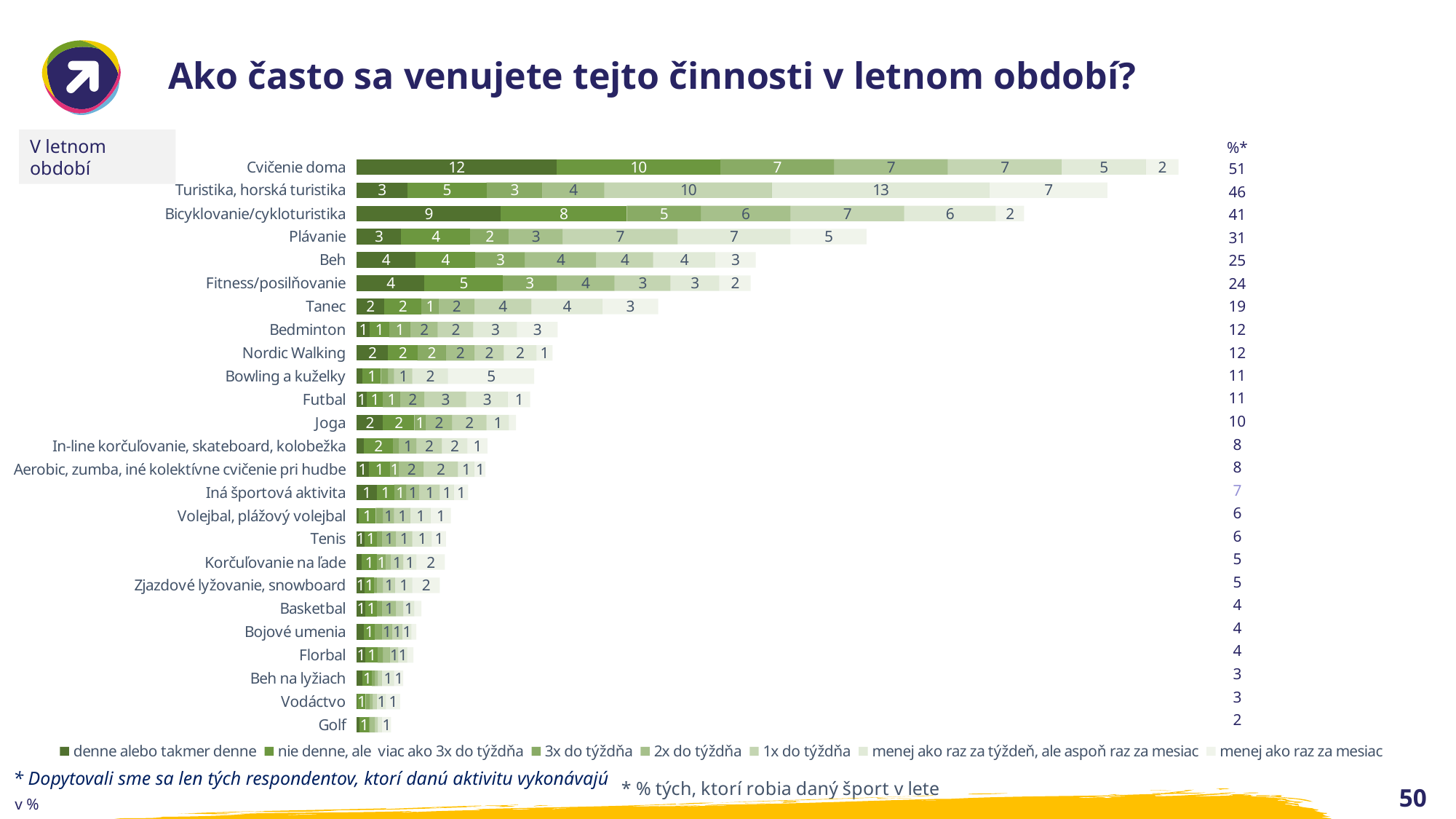
What is the value of the 'menej ako raz za týždeň, ale aspoň raz za mesiac' segment for Turistika, horská turistika? 13 What is the difference between the %* values for Cvičenie doma and Turistika, horská turistika? 5 What is the %* value shown for Bicyklovanie/cykloturistika? 41 What is the value of the 'nie denne, ale viac ako 3x do týždňa' segment for Bicyklovanie/cykloturistika? 8 What is the title of the slide? Ako často sa venujete tejto činnosti v letnom období? What kind of chart is shown on the slide? Stacked bar chart How many activities (categories) are plotted in the chart? 25 How many series does the legend list? 7 Which has a larger %* value, Plávanie or Beh? Plávanie What is the value of the 'denne alebo takmer denne' segment for Cvičenie doma? 12 Which activity has the lowest %* value? Golf Which activity has the highest %* value? Cvičenie doma